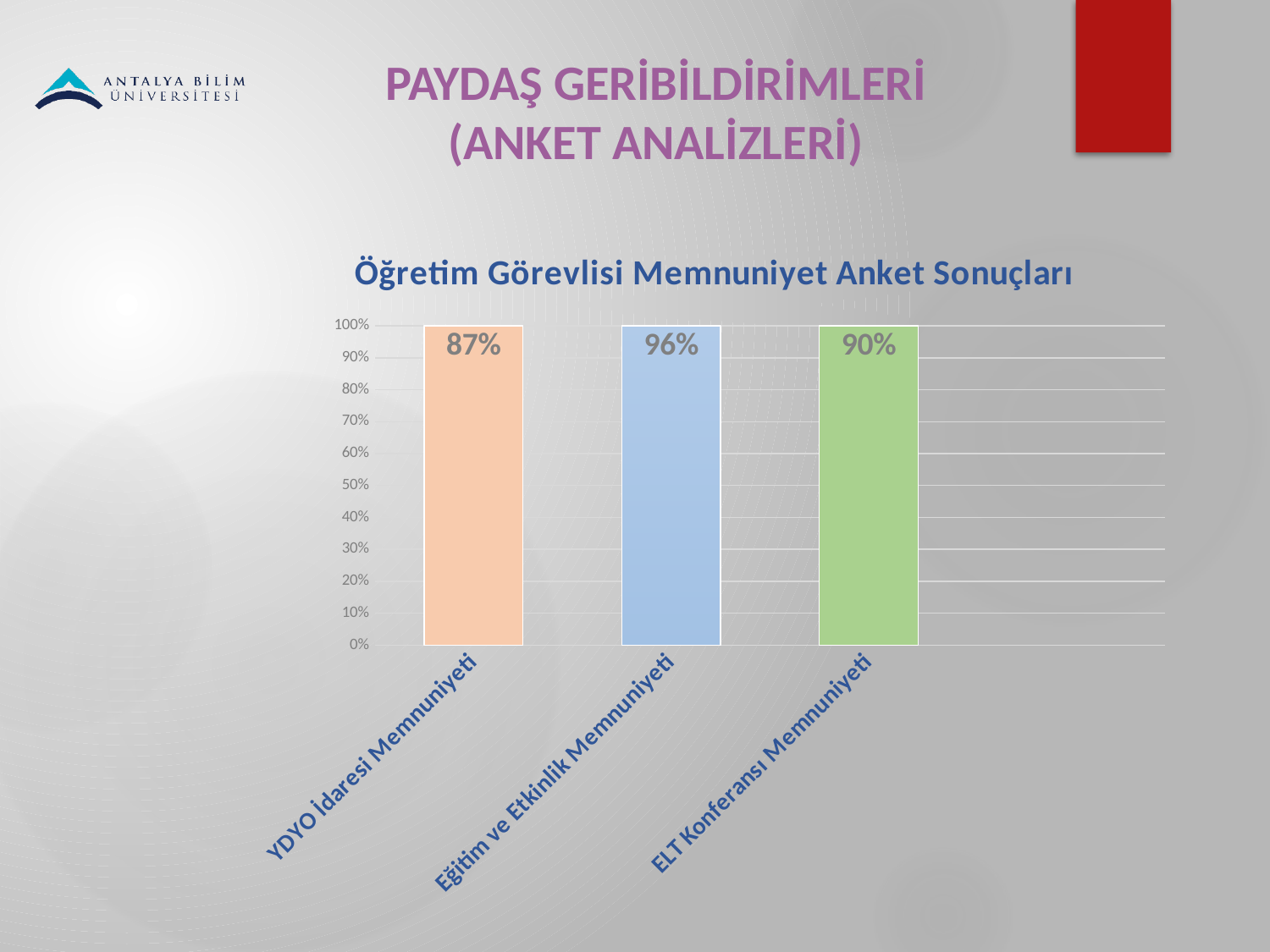
What is the value for YDYO İdaresi Memnuniyeti? 87% How many categories are shown in the chart? 3 What is the difference between the values for Eğitim ve Etkinlik Memnuniyeti and YDYO İdaresi Memnuniyeti? 9% What kind of chart is shown on the slide? bar chart What is the value for ELT Konferansı Memnuniyeti? 90% Which category has the lowest value? YDYO İdaresi Memnuniyeti Which category has the highest value? Eğitim ve Etkinlik Memnuniyeti What is the value for Eğitim ve Etkinlik Memnuniyeti? 96% What is the difference between the values for ELT Konferansı Memnuniyeti and YDYO İdaresi Memnuniyeti? 3% What is the title of the chart? Öğretim Görevlisi Memnuniyet Anket Sonuçları Which is larger, the value for ELT Konferansı Memnuniyeti or the value for YDYO İdaresi Memnuniyeti? ELT Konferansı Memnuniyeti Is the value for YDYO İdaresi Memnuniyeti greater or less than 90%? less